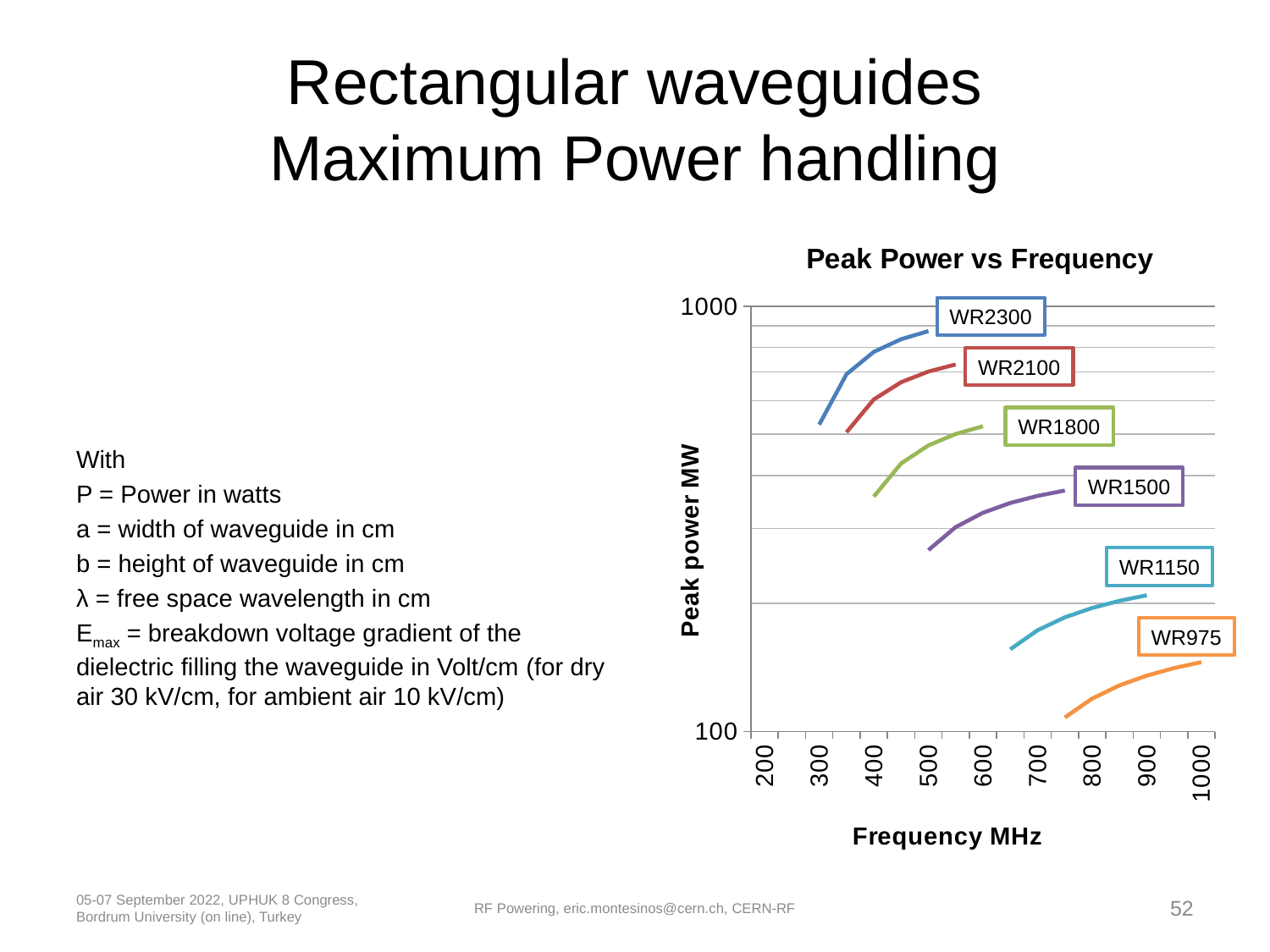
Which waveguide series starts at the lowest frequency in the chart? WR2300 Which has a higher peak power, WR2300 or WR975? WR2300 Is the peak power of WR975 greater or less than 1000 MW? less What kind of chart is shown on the slide? Line chart What is the highest value labelled on the vertical axis of the chart? 1000 Which waveguide series has the lowest peak power in the chart? WR975 What is the title of the chart? Peak Power vs Frequency What is the label of the vertical axis of the chart? Peak power MW How many series (waveguide types) are shown in the Peak Power vs Frequency chart? 6 Which has a higher peak power, WR1800 or WR1150? WR1800 Does the peak power of each waveguide rise or fall as frequency increases? Rise Which waveguide series reaches the highest peak power in the chart? WR2300